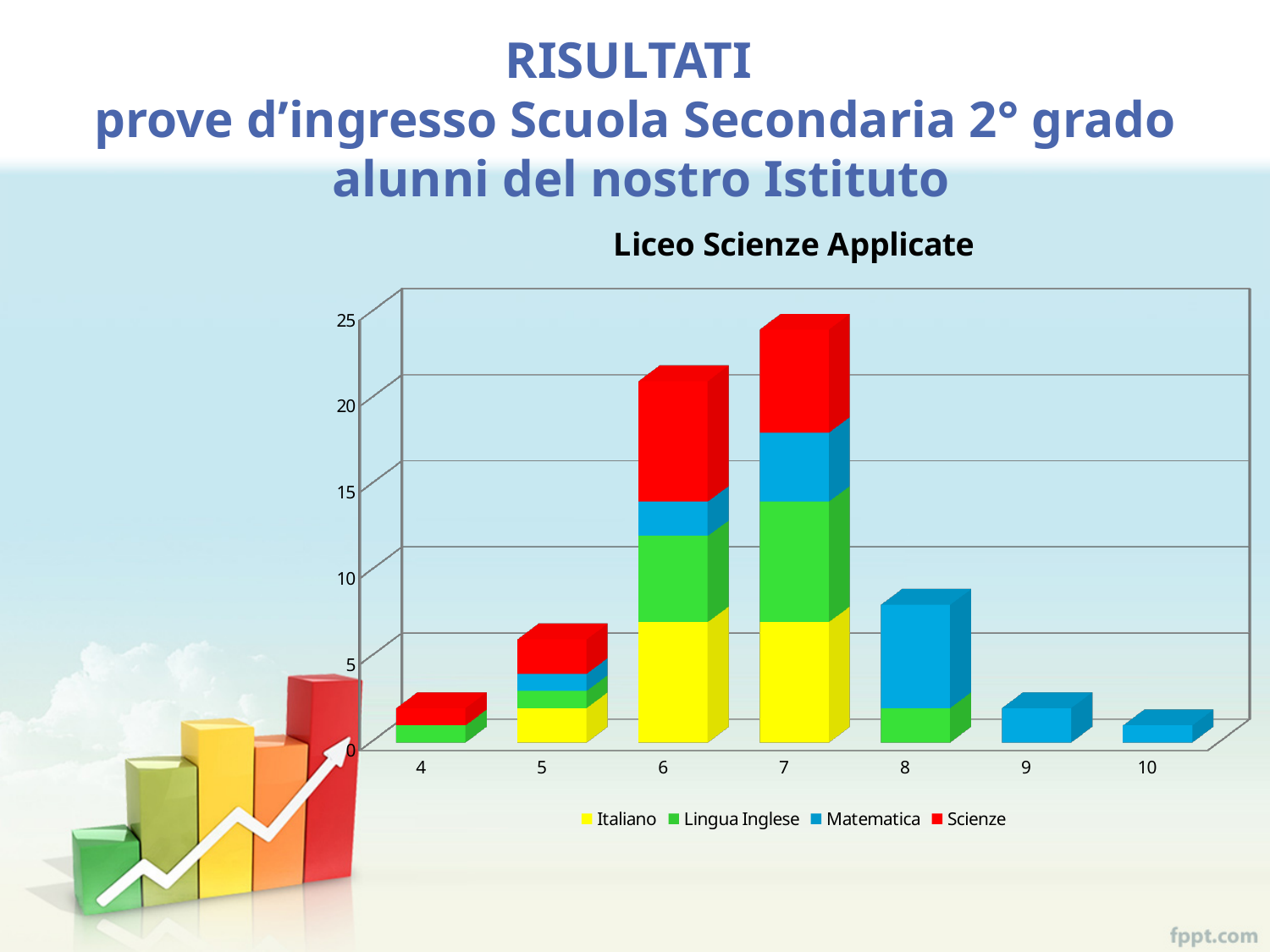
Is the total value for category 4 greater or less than 5? less Which series is shown in red in the legend? Scienze Is the total value for category 8 greater or less than 10? less Is the total value for category 7 greater or less than 20? greater How many categories are shown on the x axis? 7 What type of chart is shown on the slide? stacked bar chart Do the total bar heights rise or fall from category 7 to category 10? fall Which category has the highest total stacked bar? 7 Which has the larger total stacked bar, category 6 or category 8? 6 What is the title of the chart? Liceo Scienze Applicate How many series does the legend list? 4